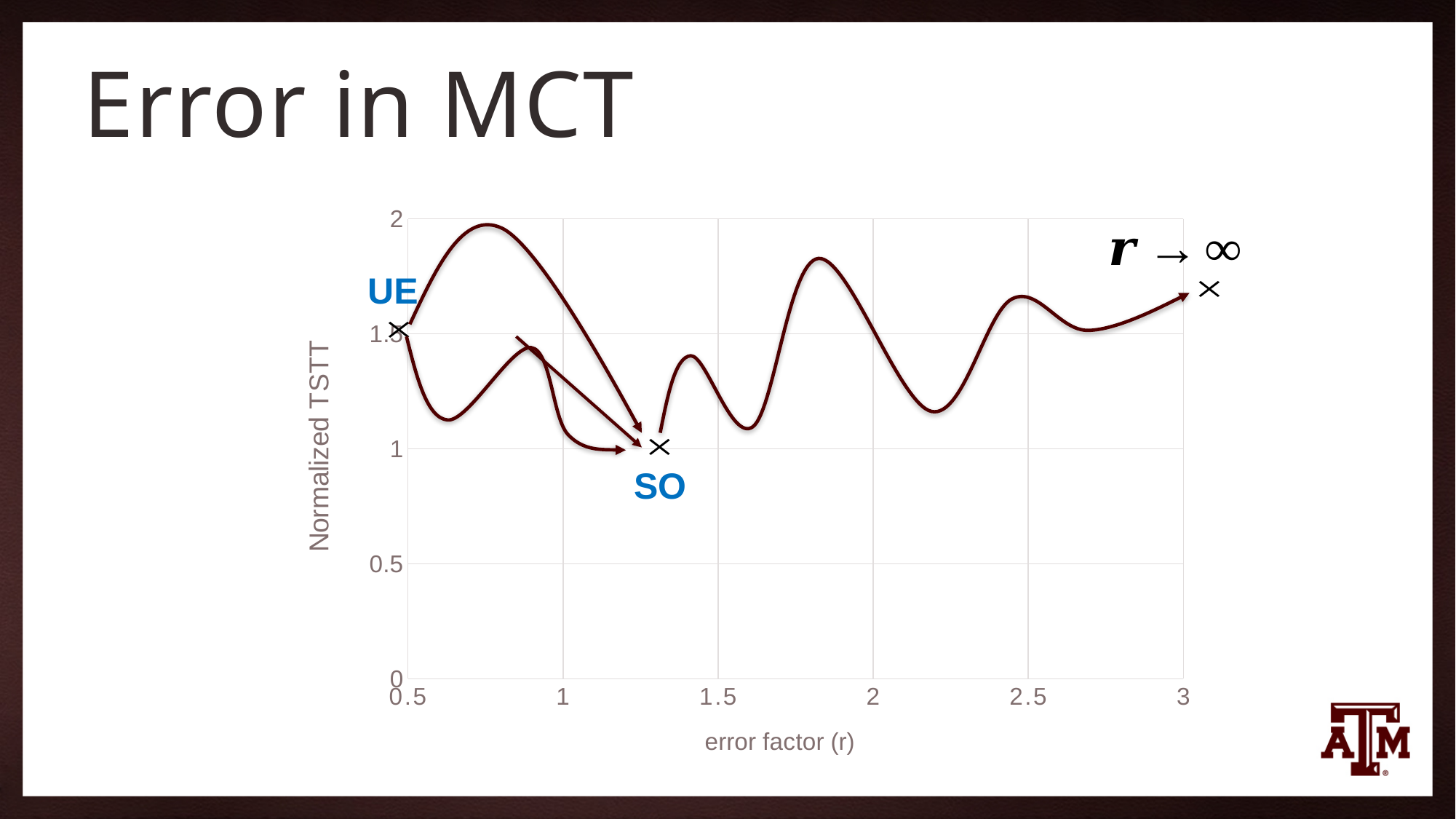
Is the value of the curve at an error factor of 2.5 greater or less than 1.5? greater Is the value of the curve at an error factor of 3 greater or less than 1? greater Is the value of the curve at an error factor of 1.5 greater or less than 1.5? less What is the label of the x axis of the chart? error factor (r) Which is larger, the value of the curve at an error factor of 2.2 or at an error factor of 2.5? 2.5 What is the label of the y axis of the chart? Normalized TSTT What kind of chart is shown on the slide? line chart Which is larger, the value of the curve at an error factor of 0.75 or at an error factor of 1.3? 0.75